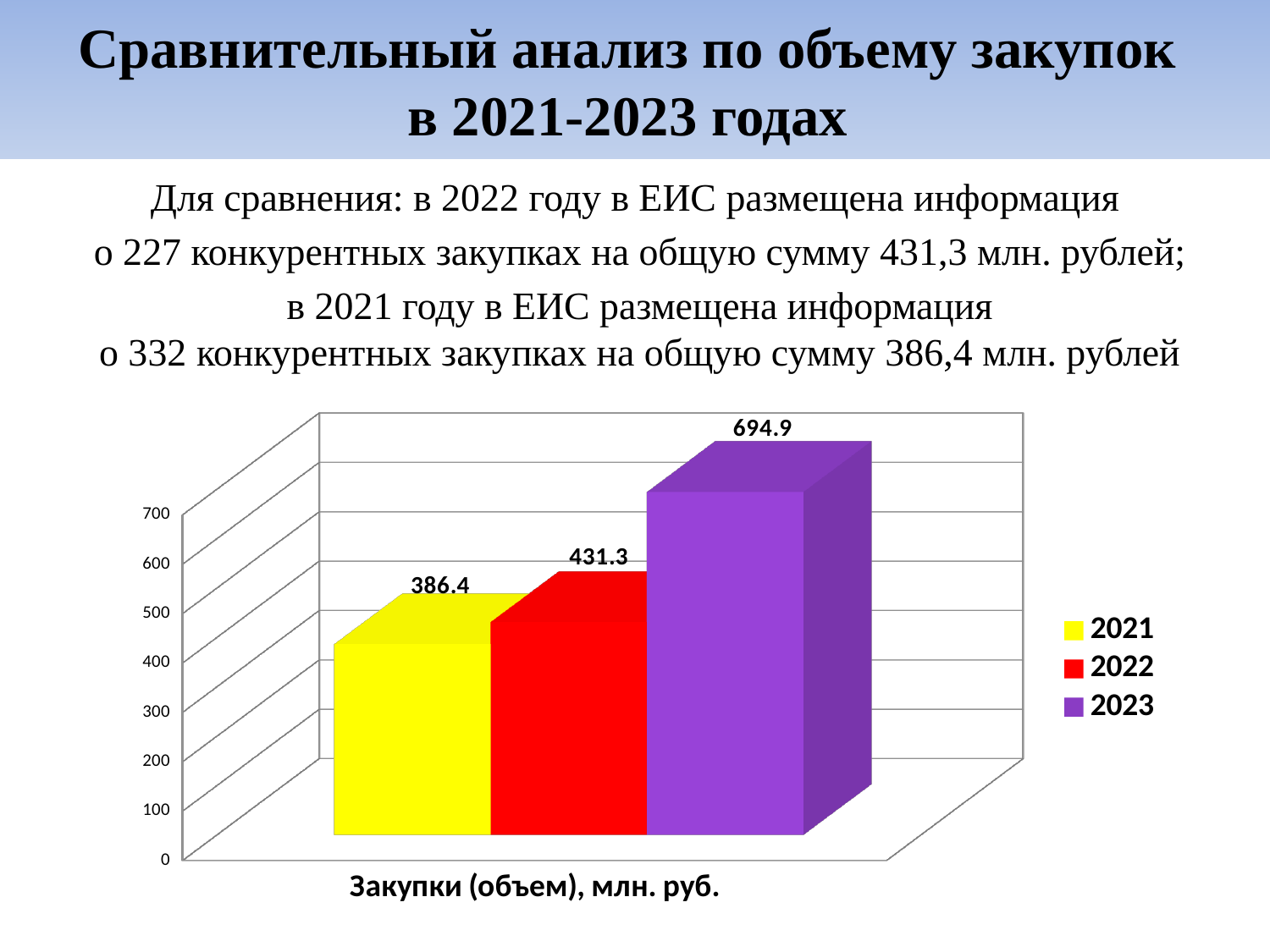
What colour is the bar for 2023? purple Do the values rise or fall from 2021 to 2023? rise How many series does the legend list? 3 Which is larger, the value for 2022 or the value for 2021? 2022 What is the difference between the values for 2023 and 2022? 263.6 What is the value for 2022 in the chart? 431.3 Which year has the lowest value in the chart? 2021 What is the value for 2023 in the chart? 694.9 What is the value for 2021 in the chart? 386.4 Which year has the highest value in the chart? 2023 What kind of chart is shown on the slide? bar chart What is the difference between the values for 2022 and 2021? 44.9